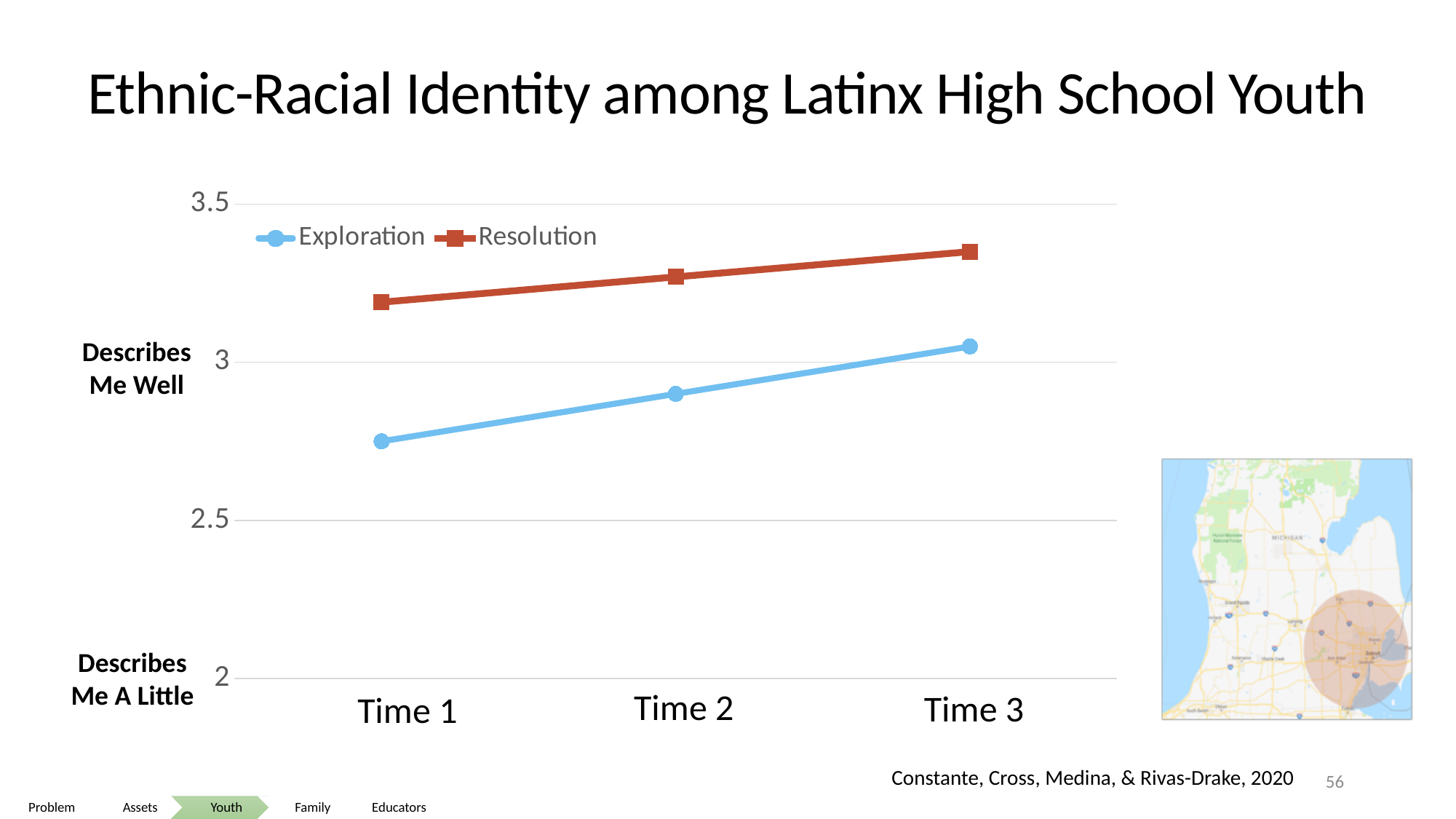
Is the value for Exploration at Time 1 greater or less than 3? less How many series does the legend list? 2 Does the Exploration line rise or fall from Time 1 to Time 3? rise What is the title of the chart on the slide? Ethnic-Racial Identity among Latinx High School Youth What kind of chart is shown on the slide? line chart Does the Resolution line rise or fall from Time 1 to Time 3? rise At Time 1, which is larger, Exploration or Resolution? Resolution Is the value for Resolution at Time 3 greater or less than 3.5? less How many time points are plotted along the x axis? 3 Is the value for Resolution at Time 1 greater or less than 3? greater At which time point is Resolution lowest? Time 1 At which time point is Exploration highest? Time 3